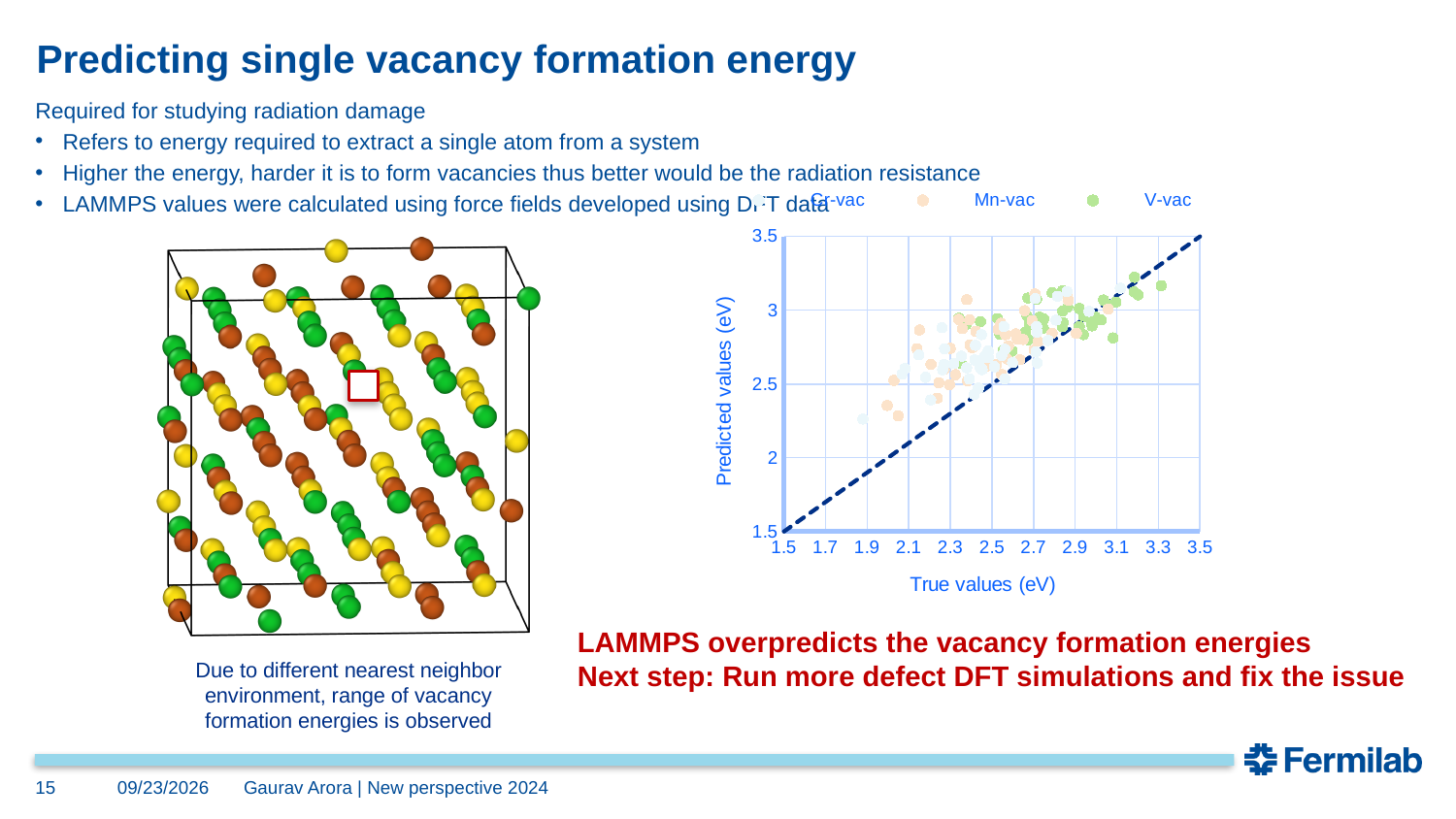
Are the Mn-vac points in the scatter chart mostly greater or less than 2 on the y axis? greater What kind of chart is shown on the right side of the slide? scatter chart Are the V-vac points in the scatter chart mostly greater or less than 2.5 on the y axis? greater Do the predicted values in the scatter chart generally rise or fall as the true values increase? rise What is the lowest value shown on the y axis of the scatter chart? 1.5 What is the title of the x axis of the scatter chart? True values (eV) Which series in the scatter chart is plotted in green? V-vac What is the highest value shown on the x axis of the scatter chart? 3.5 How many series does the legend of the scatter chart list? 3 What is the title of the y axis of the scatter chart? Predicted values (eV)